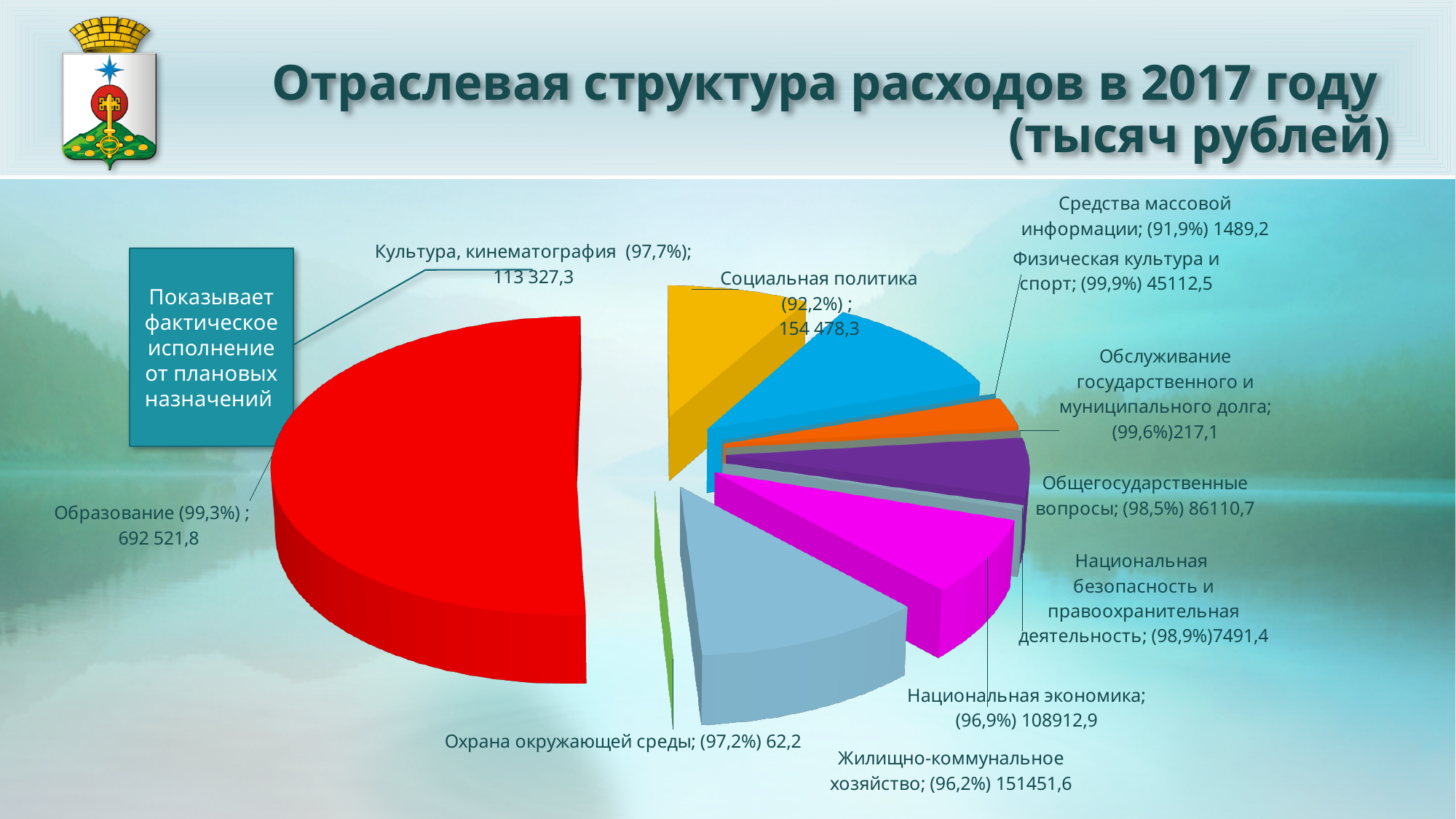
What kind of chart is shown on the slide? pie chart What is the value for Социальная политика? 154 478,3 What execution percentage is shown for Физическая культура и спорт? 99,9% What is the value for Охрана окружающей среды? 62,2 Which category has the smallest value? Охрана окружающей среды What is the value for Образование? 692 521,8 How many categories (slices) does the pie chart show? 11 Which is larger: Культура, кинематография or Национальная экономика? Культура, кинематография What is the value for Жилищно-коммунальное хозяйство? 151451,6 What is the title of the chart on the slide? Отраслевая структура расходов в 2017 году (тысяч рублей) Which category has the largest value? Образование What is the difference between the values for Социальная политика and Жилищно-коммунальное хозяйство? 3026,7